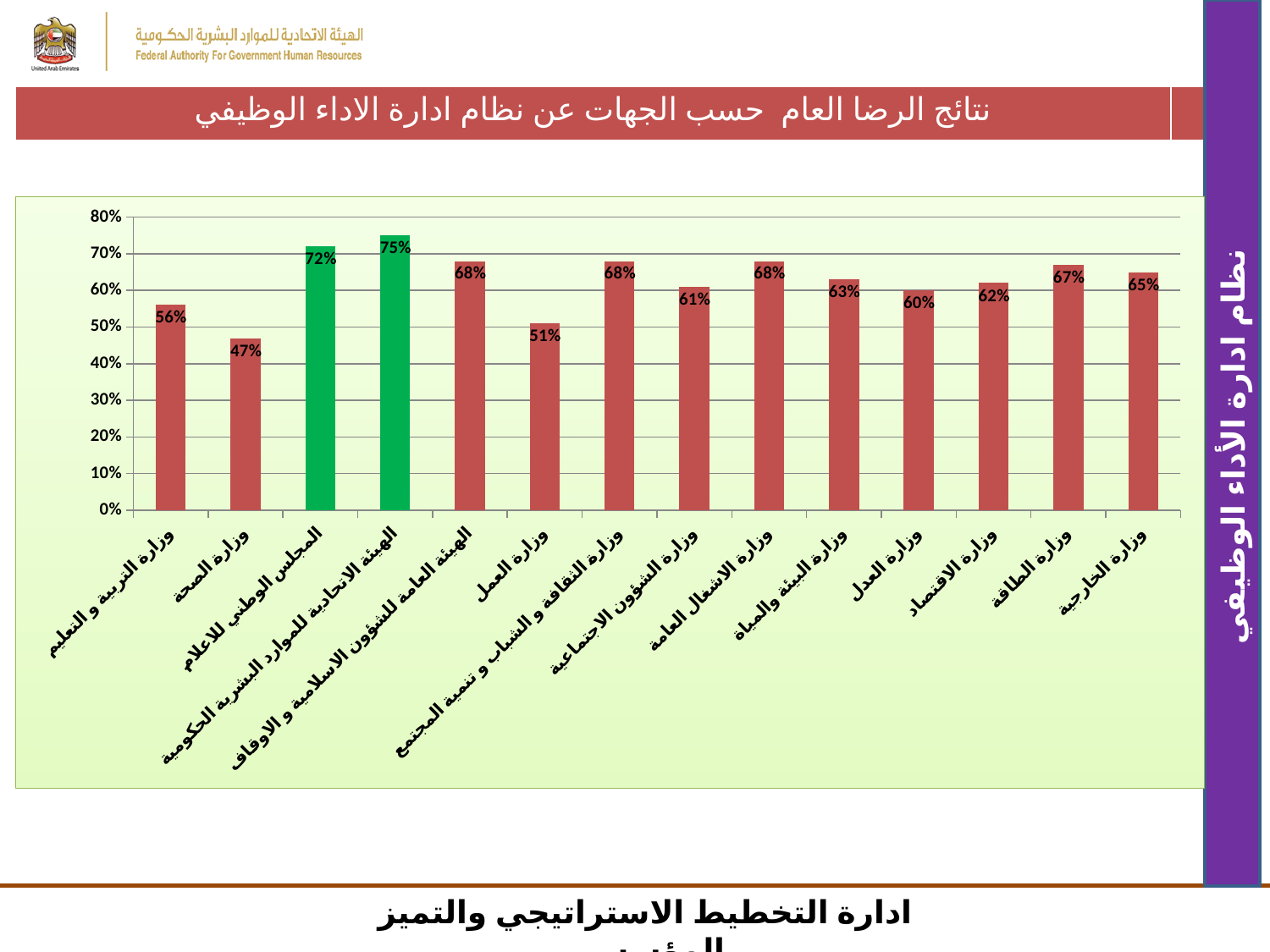
Which entity has the lowest value? وزارة الصحة Which is larger, the value for وزارة الطاقة or the value for وزارة الاقتصاد? وزارة الطاقة What kind of chart is shown on the slide? Bar chart What is the value for وزارة الخارجية? 65% What is the value for وزارة العمل? 51% What is the difference between the values for المجلس الوطني للاعلام and وزارة التربية و التعليم? 16% How many bars are coloured green? 2 What is the value for الهيئة الاتحادية للموارد البشرية الحكومية? 75% What is the value for وزارة الصحة? 47% What is the title of the chart on the slide? نتائج الرضا العام حسب الجهات عن نظام ادارة الاداء الوظيفي How many entities are shown on the chart? 14 Which entity has the highest value? الهيئة الاتحادية للموارد البشرية الحكومية